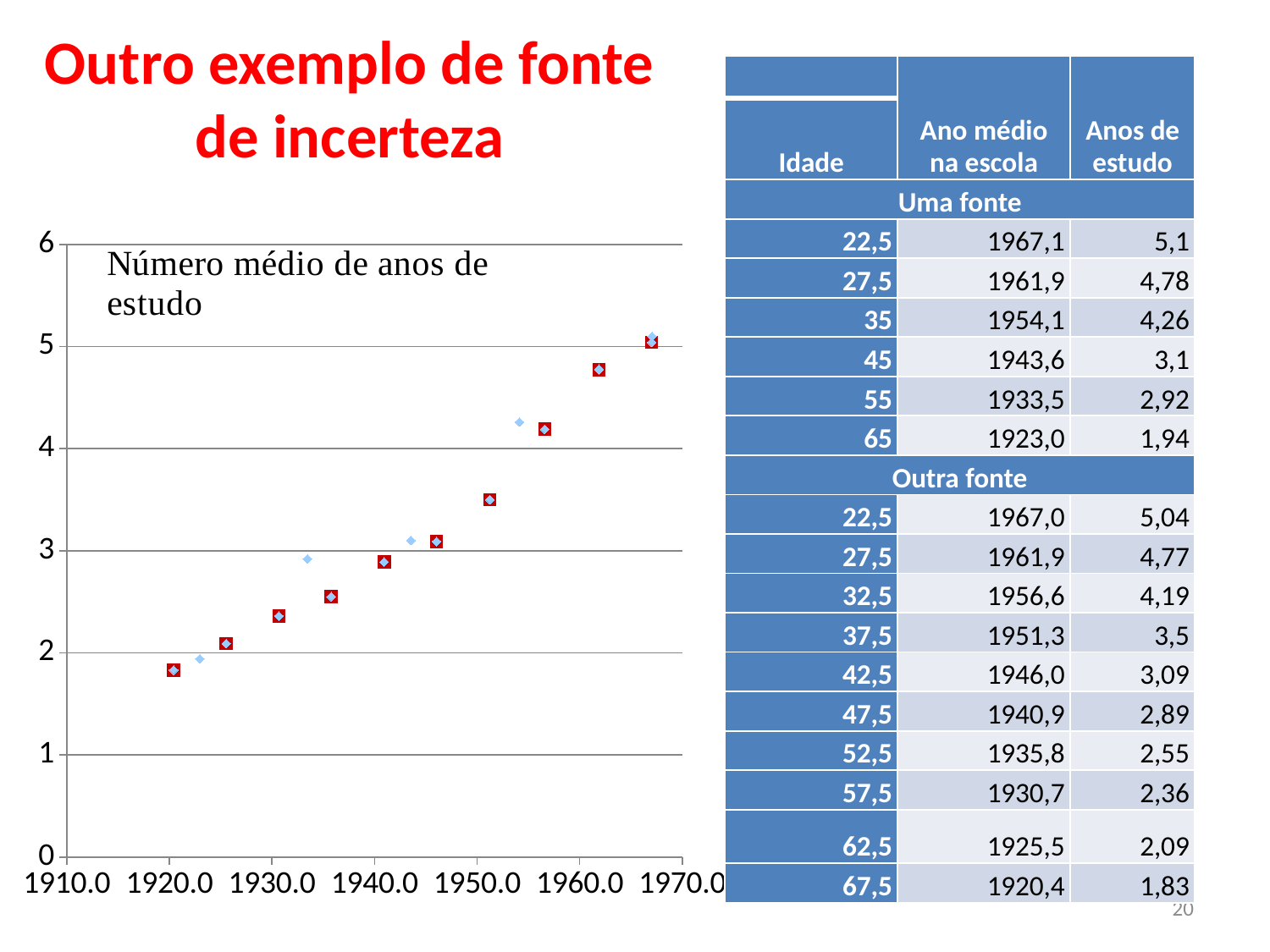
Is the value of the point near 1962 greater or less than 4? greater Is the value of the point near 1957 greater or less than 4? greater Which point has the higher value: the one near 1946 or the one near 1962? the one near 1962 Is the value of the leftmost point (near 1920) greater or less than 2? less What is the highest value shown on the y axis of the chart? 6 What is the title of the chart? Número médio de anos de estudo Do the plotted values rise or fall as the year on the x axis increases? rise What kind of chart is shown on the slide? scatter chart How many red-outlined points are plotted on the chart? 10